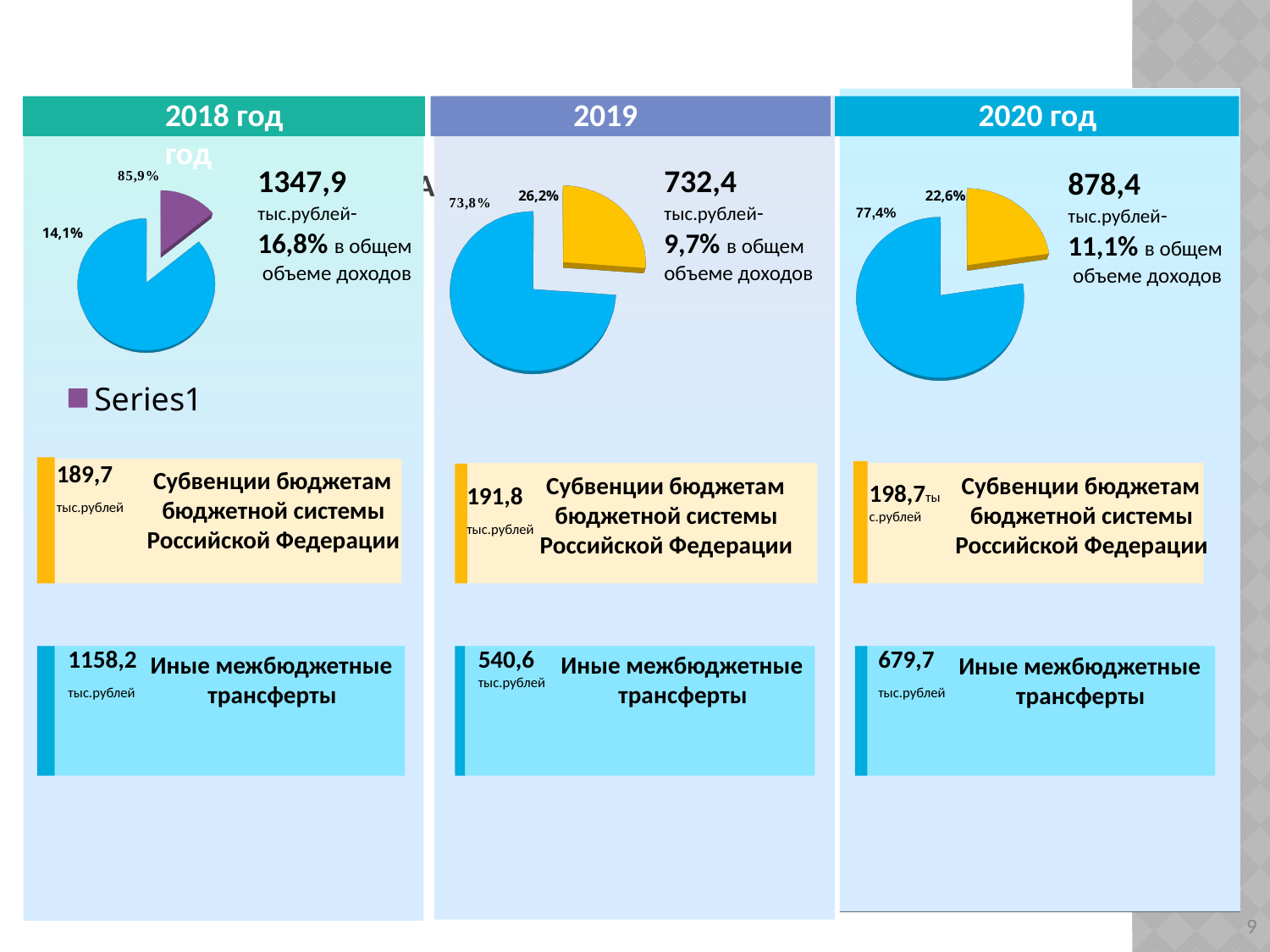
In the 2020 год pie chart, which slice is larger, the blue one or the yellow one? the blue one What legend entry is shown below the 2018 год pie chart? Series1 Which of the three pie charts has the largest smaller slice: 2018 год, 2019 or 2020 год? 2019 In the 2018 год pie chart, what percentage is shown for the larger (blue) slice? 85,9% In the 2019 pie chart, what is the difference between the blue slice's percentage and the yellow slice's percentage? 47,6% What kind of chart is shown in the 2018 год panel? pie chart In the 2020 год pie chart, what percentage is shown for the yellow slice? 22,6% In the 2019 pie chart, what percentage is shown for the yellow slice? 26,2% How many slices does the 2019 pie chart have? 2 In the 2018 год pie chart, what percentage is shown for the smaller (purple) slice? 14,1% In the 2020 год pie chart, what percentage is shown for the blue slice? 77,4% In the 2019 pie chart, what percentage is shown for the blue slice? 73,8%